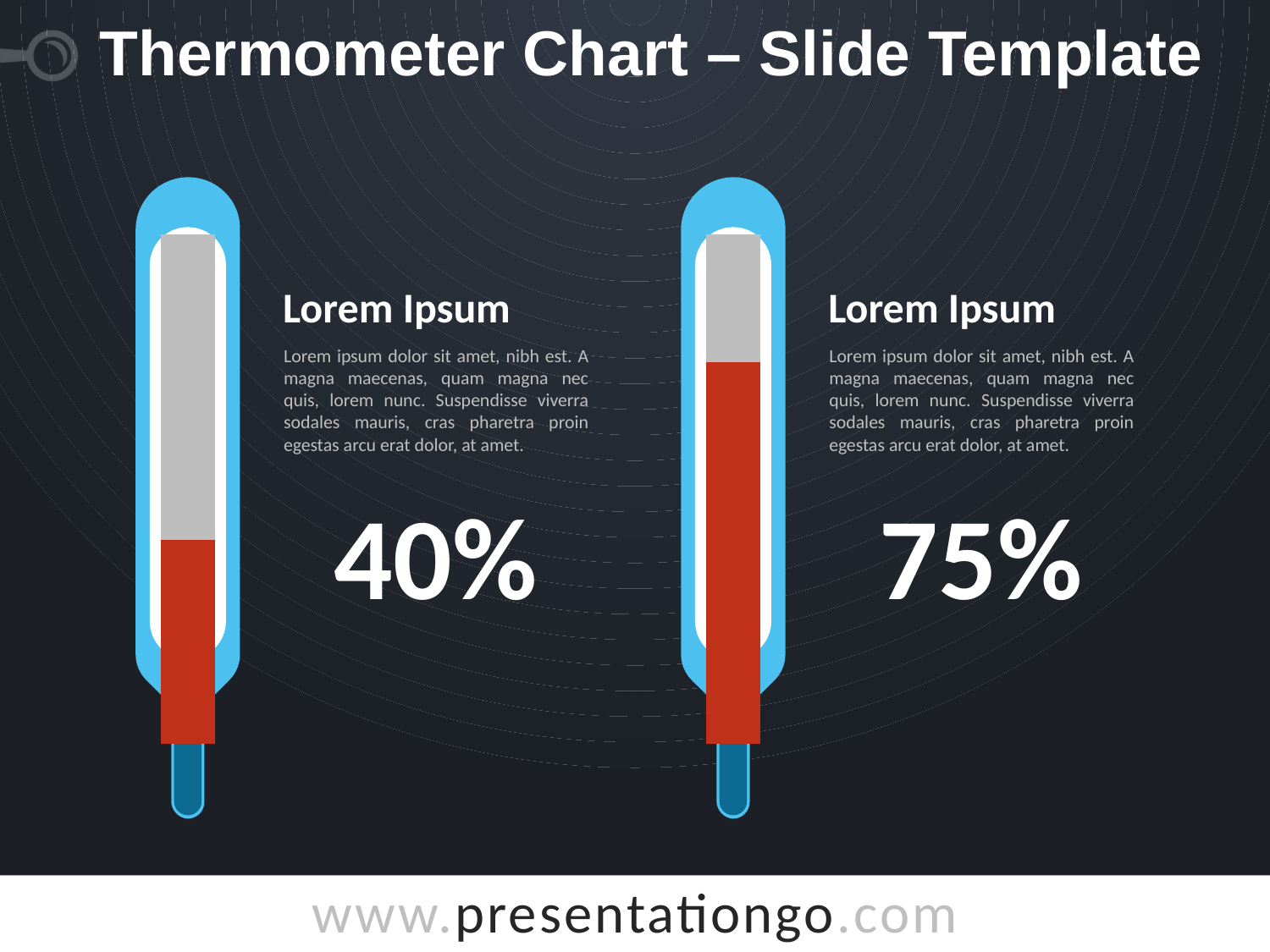
What colour is the filled portion of the thermometers? red What value is shown for the right thermometer chart? 75% Which thermometer shows the lower value, the left or the right? left What is the title of the slide? Thermometer Chart – Slide Template Which thermometer shows the higher value, the left or the right? right What value is shown for the left thermometer chart? 40% What kind of chart is used on this slide? thermometer chart Is the value of the left thermometer greater or less than 50%? less Is the value of the right thermometer greater or less than 50%? greater How many thermometer charts are shown on the slide? 2 What is the difference between the right thermometer's value and the left thermometer's value? 35%